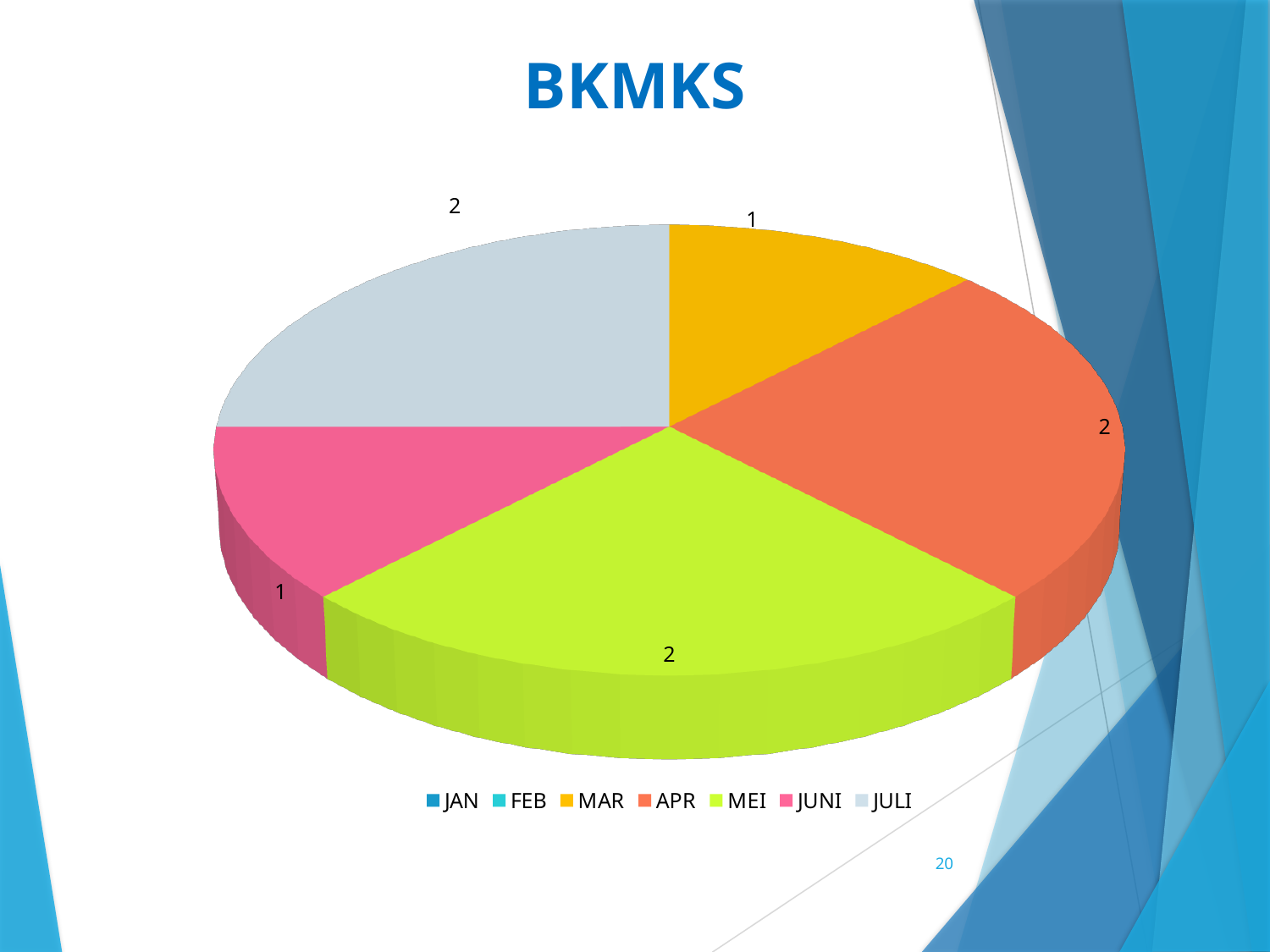
What colour is the MEI slice? green Which is larger, the APR slice or the MAR slice? APR What is the difference between the MEI value and the JUNI value? 1 What is the value of the MAR slice? 1 What type of chart is shown on the slide? pie chart How many entries does the legend list? 7 What is the value of the JUNI slice? 1 What is the value of the APR slice? 2 What is the title of the chart? BKMKS What is the value of the JULI slice? 2 What is the value of the MEI slice? 2 What share of the pie does the APR slice represent? 25%